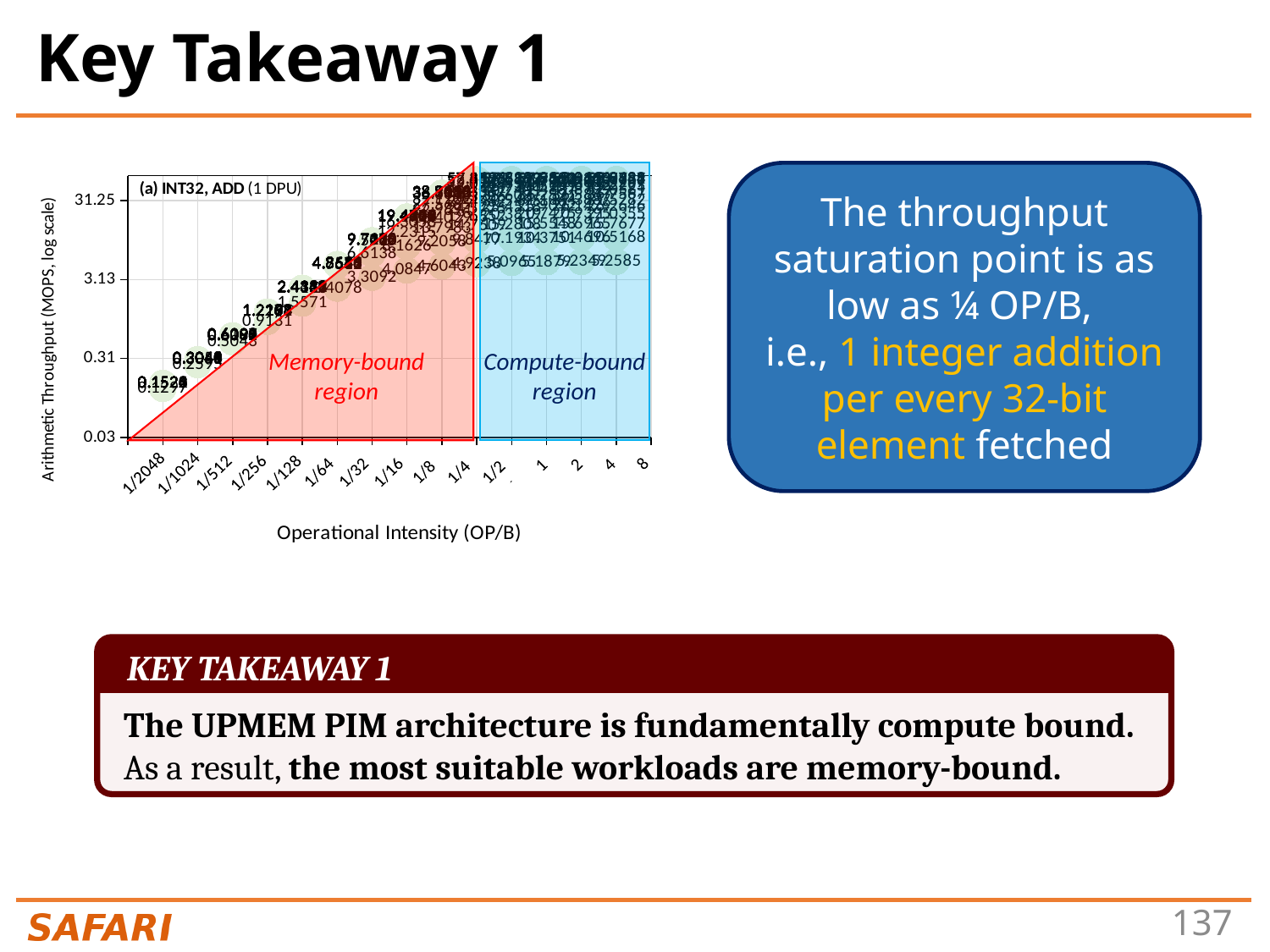
What is the title shown inside the chart? (a) INT32, ADD (1 DPU) Is the arithmetic throughput at operational intensity 1/64 greater or less than 0.31? greater What is the label of the x axis of the chart? Operational Intensity (OP/B) Which has the higher arithmetic throughput: operational intensity 1/1024 or 1/16? 1/16 Is the arithmetic throughput at operational intensity 1/8 greater or less than 3.13? greater Which operational intensity has the lowest arithmetic throughput in the chart? 1/2048 Is the arithmetic throughput at operational intensity 1/2048 greater or less than 0.31? less How many tick labels are shown on the y axis of the chart? 4 Does the arithmetic throughput rise or fall as operational intensity increases from 1/2048 to 1/4? rise How many tick labels are shown on the x axis of the chart? 15 Which region of the chart is shaded red? Memory-bound region